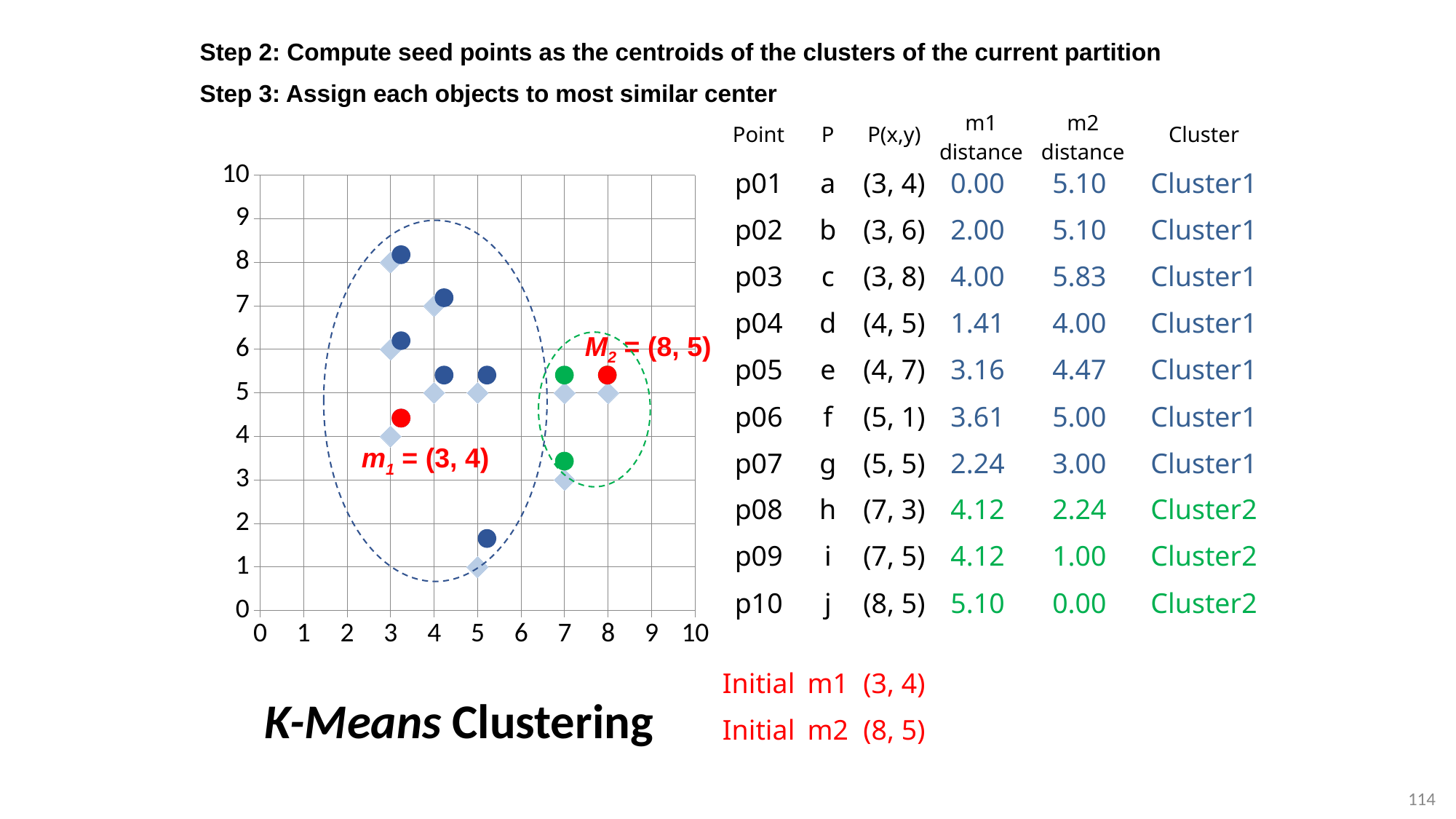
What are the coordinates of the centroid labelled M2 on the chart? (8, 5) What kind of chart is shown on the slide? scatter chart How many data points (diamond markers) are plotted on the chart? 10 What are the coordinates of the centroid labelled m1 on the chart? (3, 4) How many plotted points lie inside the blue dashed ellipse (Cluster1)? 7 What is the maximum value shown on the x axis of the chart? 10 What is the maximum value shown on the y axis of the chart? 10 Is the y value of the point at x = 5 inside the blue ellipse near the bottom greater or less than 2? less Which plotted point has the lowest y value? (5, 1) Which plotted point has the highest y value? (3, 8) Which plotted point has the highest x value? (8, 5) How many plotted points lie inside the green dashed ellipse (Cluster2)? 3